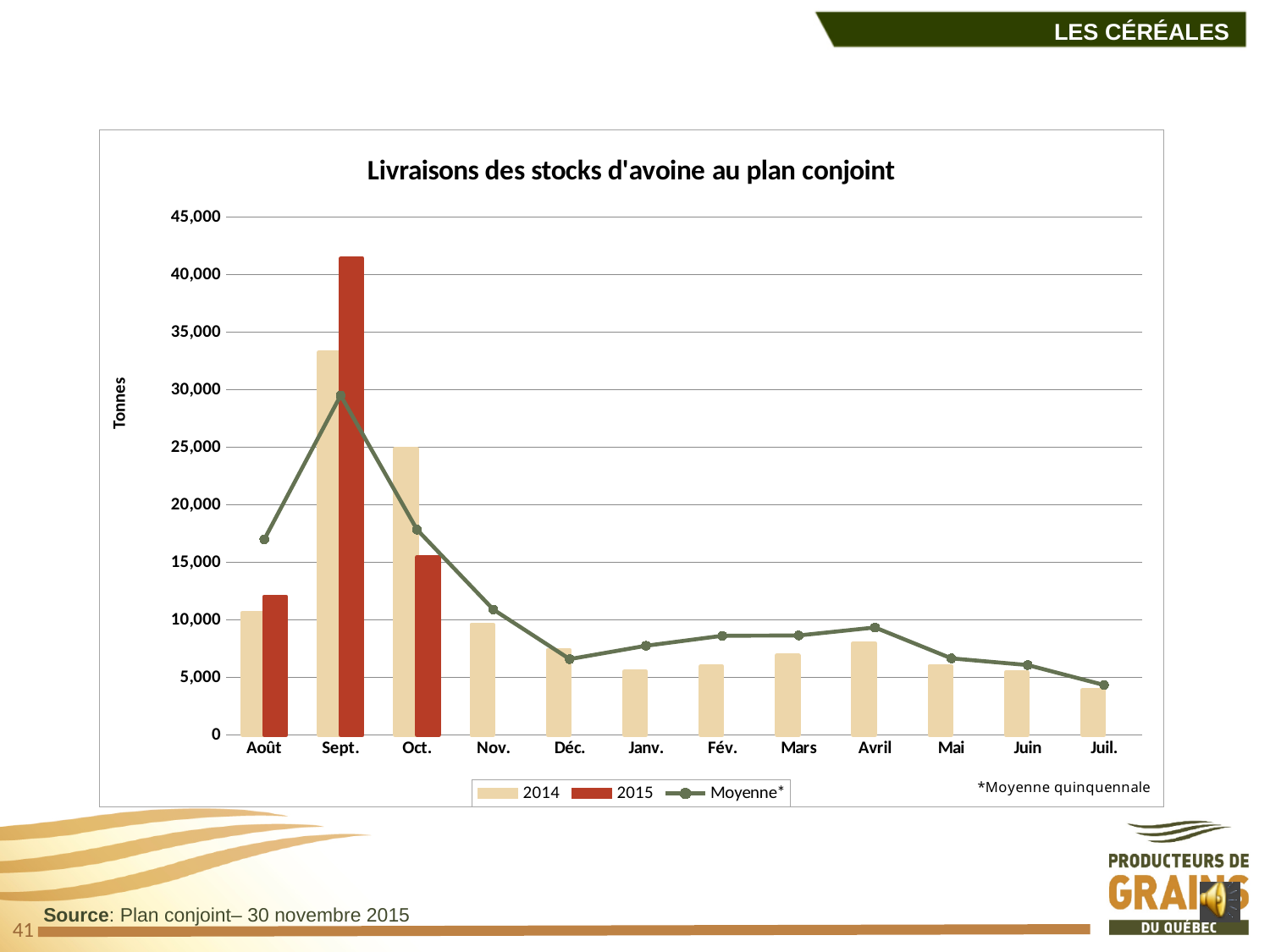
Does the Moyenne* line rise or fall from Avril to Juil.? fall In which month is the 2014 value highest? Sept. Is the Moyenne* value for Août greater or less than 15,000? greater For Oct., which is larger: the 2014 value or the 2015 value? 2014 How many months are shown on the x axis? 12 Is the 2015 value for Sept. greater or less than 40,000? greater Is the 2014 value for Sept. greater or less than 35,000? less For Août, which is larger: the 2014 value or the 2015 value? 2015 In which month is the 2015 value highest? Sept. What kind of chart is shown on the slide? bar chart with a line How many series does the legend list? 3 In which month is the 2014 value lowest? Juil.